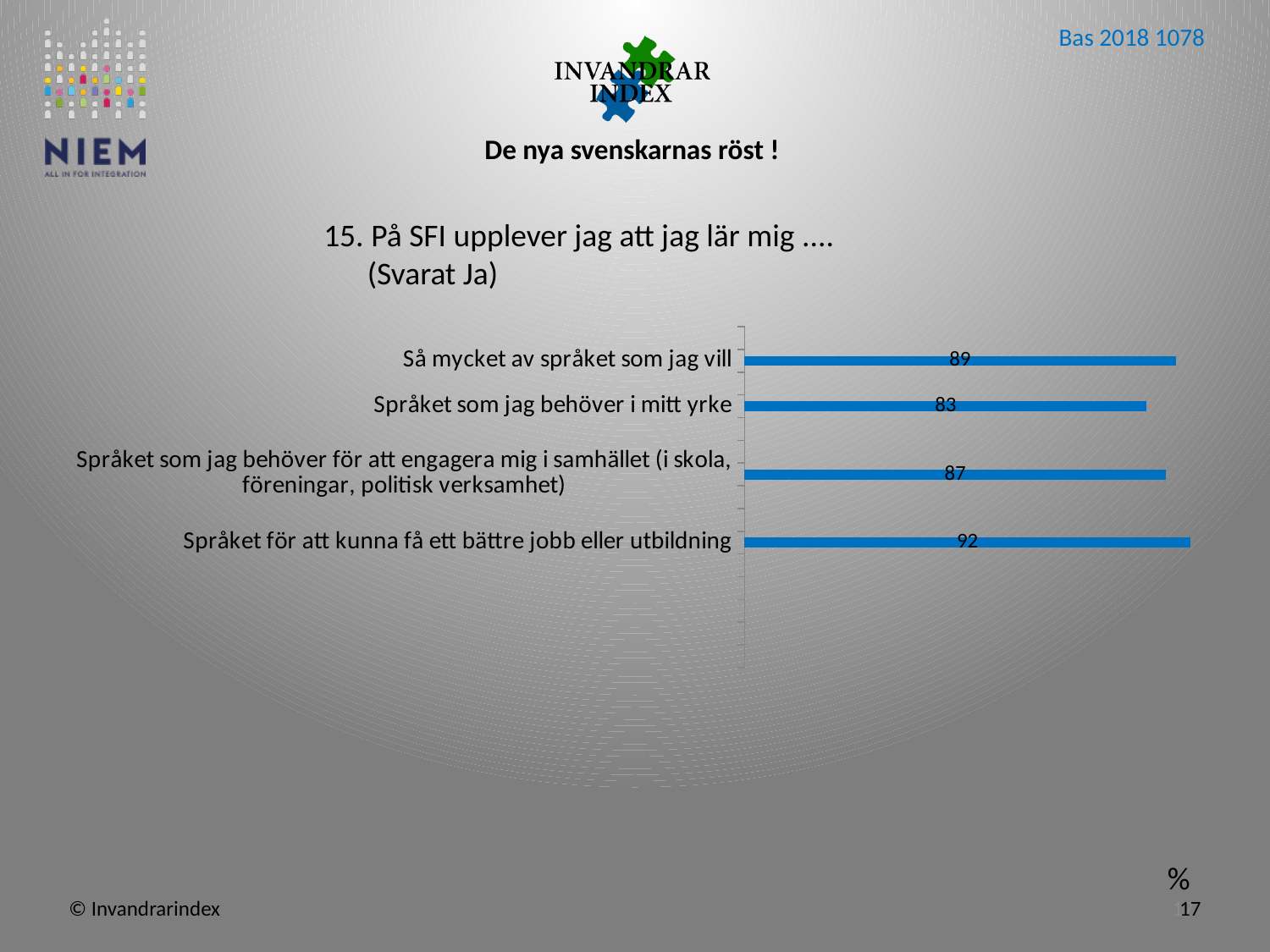
What is the value for "Språket som jag behöver i mitt yrke"? 83 Which category has the highest value? Språket för att kunna få ett bättre jobb eller utbildning Which category has the lowest value? Språket som jag behöver i mitt yrke What is the value for "Språket som jag behöver för att engagera mig i samhället (i skola, föreningar, politisk verksamhet)"? 87 What is the title of the chart? 15. På SFI upplever jag att jag lär mig .... (Svarat Ja) What is the value for "Så mycket av språket som jag vill"? 89 What kind of chart is shown on the slide? Bar chart Which is larger: the value for "Så mycket av språket som jag vill" or the value for "Språket som jag behöver i mitt yrke"? Så mycket av språket som jag vill What is the difference between the values for "Så mycket av språket som jag vill" and "Språket som jag behöver för att engagera mig i samhället (i skola, föreningar, politisk verksamhet)"? 2 What is the difference between the values for "Språket för att kunna få ett bättre jobb eller utbildning" and "Språket som jag behöver i mitt yrke"? 9 How many categories are shown in the chart? 4 What is the value for "Språket för att kunna få ett bättre jobb eller utbildning"? 92